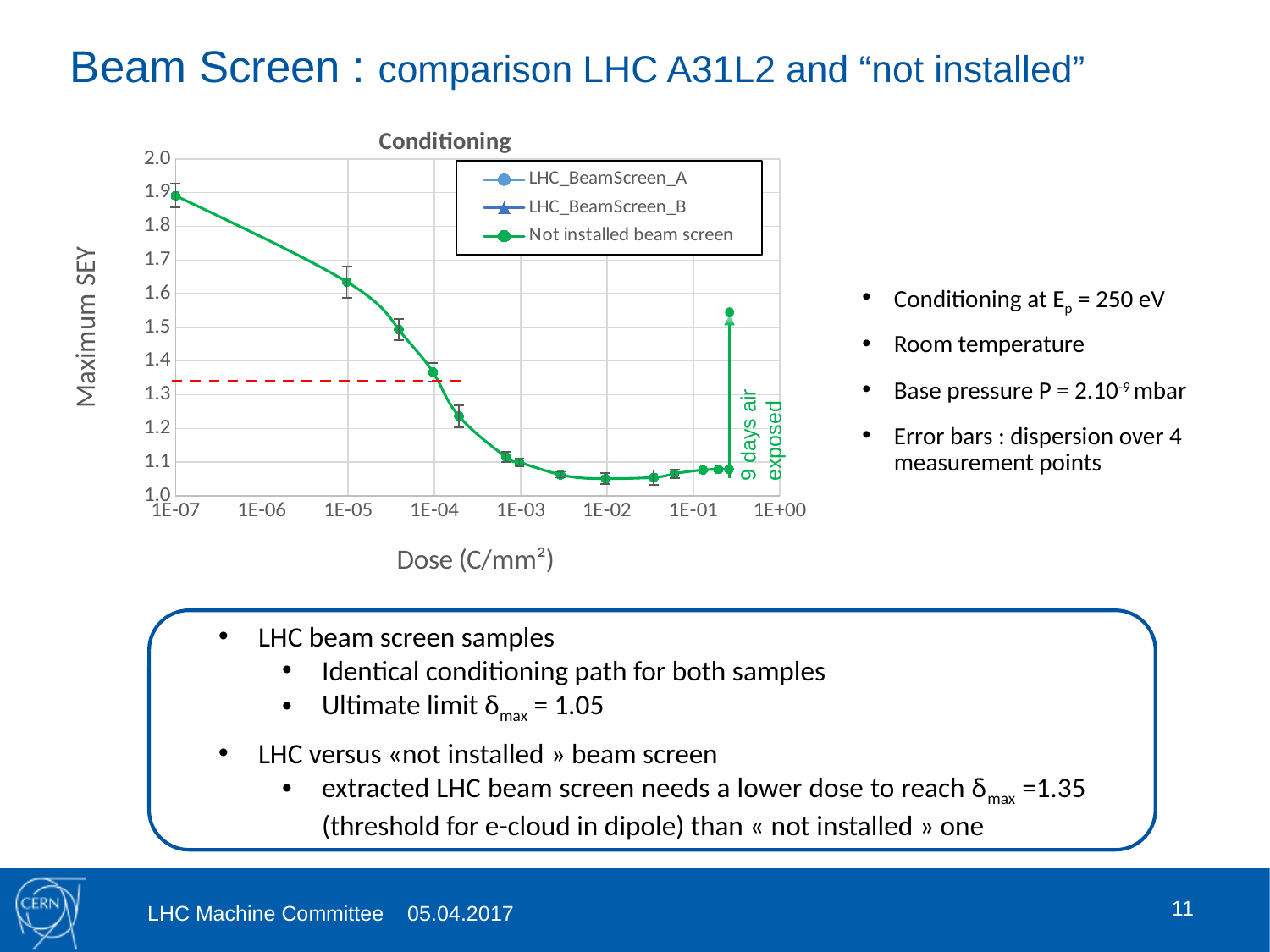
Is the Maximum SEY of the Not installed beam screen at a dose of 1E-02 C/mm² greater or less than 1.1? less At which dose does the Not installed beam screen curve reach its highest Maximum SEY? 1E-07 Is the Maximum SEY of the Not installed beam screen at a dose of 1E-07 C/mm² greater or less than 1.8? greater What is the title of the chart? Conditioning Is the Maximum SEY of the Not installed beam screen at a dose of 1E-03 C/mm² greater or less than 1.2? less What is the label of the y axis of the chart? Maximum SEY Is the Maximum SEY of the Not installed beam screen at 1E-07 C/mm² larger or smaller than its value at 1E-05 C/mm²? larger Between doses of 1E-07 and 1E-02 C/mm², does the Maximum SEY of the Not installed beam screen rise or fall? fall What is the lowest value shown on the y axis of the chart? 1.0 What kind of chart is shown on the slide? line chart How many series does the chart legend list? 3